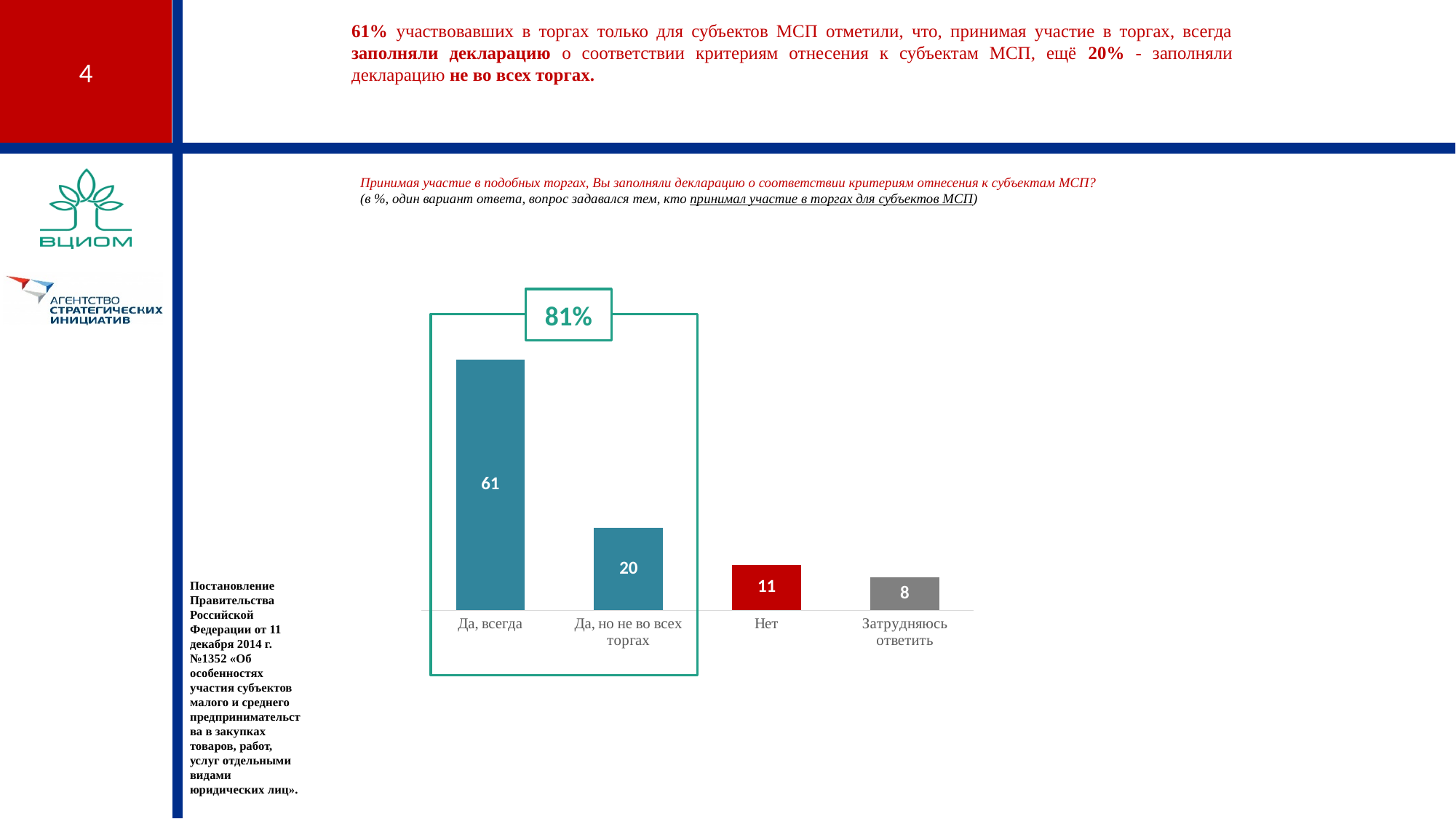
What kind of chart is shown on the slide? Bar chart What combined percentage is shown in the green box above the first two bars? 81% Which category has the lowest value? Затрудняюсь ответить How many categories are shown on the chart? 4 Which category has the highest value? Да, всегда What colour is the bar for "Нет"? Red Which is larger, the value for "Нет" or the value for "Затрудняюсь ответить"? Нет What is the value for "Да, но не во всех торгах"? 20 What is the value for "Да, всегда"? 61 What is the difference between the values for "Да, всегда" and "Да, но не во всех торгах"? 41 What is the value for "Затрудняюсь ответить"? 8 What is the value for "Нет"? 11